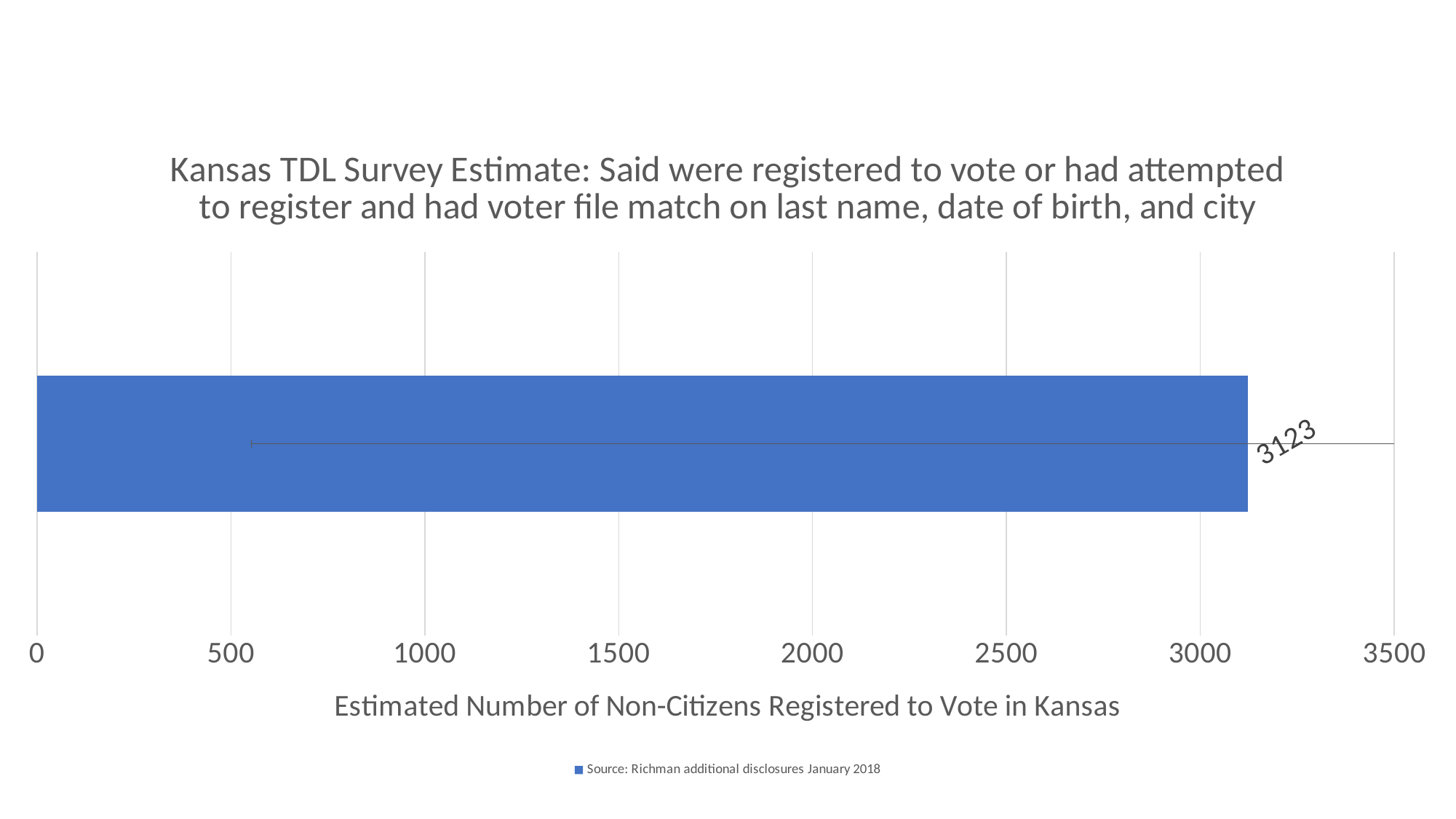
How many bars are plotted in the chart? 1 What kind of chart is shown on the slide? bar chart What is the x-axis title of the chart? Estimated Number of Non-Citizens Registered to Vote in Kansas What is the maximum value shown on the x axis? 3500 What is the legend entry shown below the chart? Source: Richman additional disclosures January 2018 How many series does the legend list? 1 Is the value of the bar greater or less than 3000? greater What is the value shown by the data label on the bar? 3123 Is the value of the bar greater or less than 3500? less